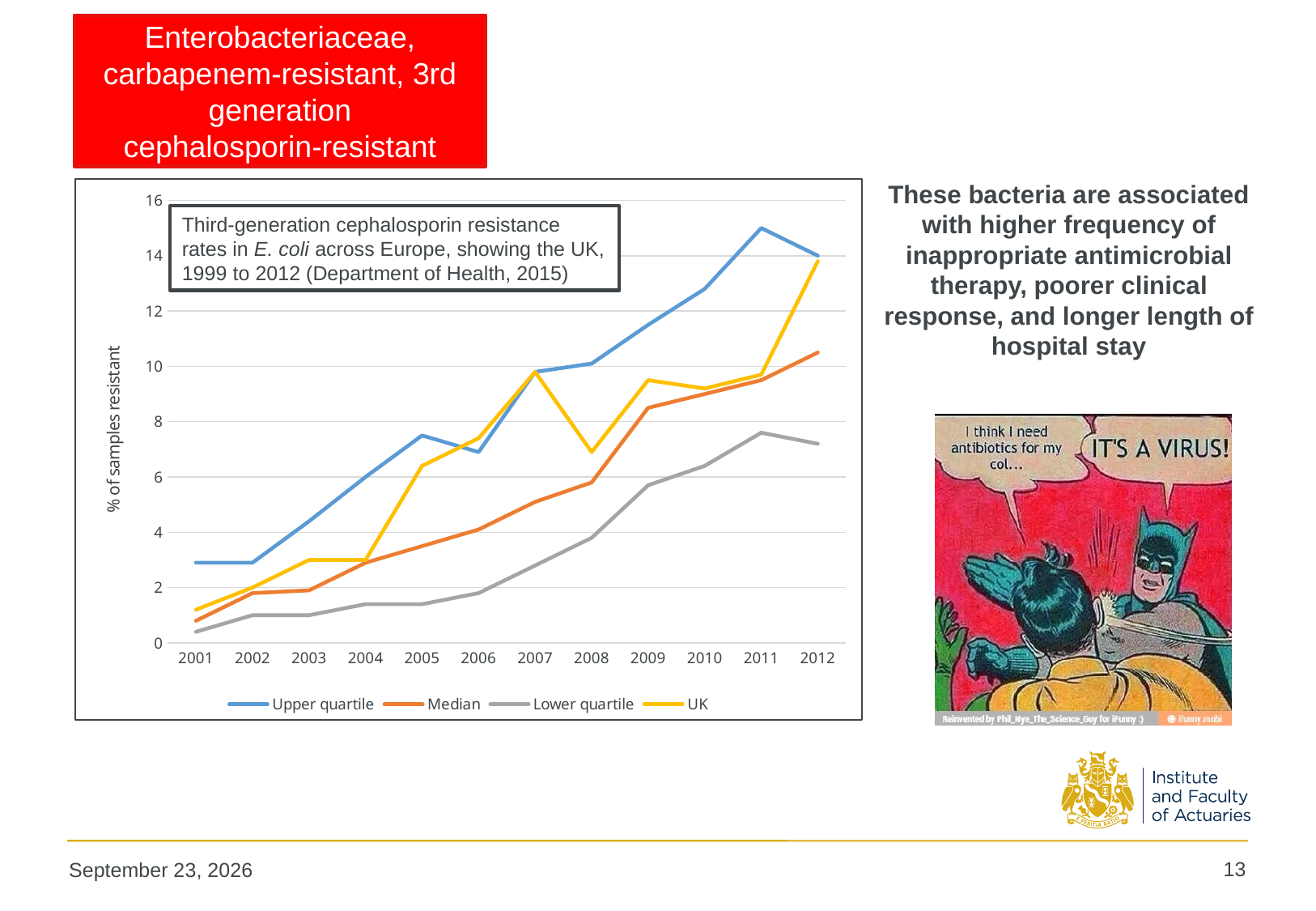
How many series does the chart's legend list? 4 Is the Lower quartile value for 2012 greater or less than 8? less Is the UK value for 2008 greater or less than 8? less Which series has the lowest value in 2001? Lower quartile What is the label on the chart's y axis? % of samples resistant Does the Upper quartile line rise or fall from 2001 to 2012? rise Is the Upper quartile value for 2011 greater or less than 14? greater What kind of chart is shown on the slide? line chart How many years are plotted along the x axis of the chart? 12 Which series has the highest value in 2011? Upper quartile In 2012, which is larger: the Upper quartile value or the Lower quartile value? Upper quartile